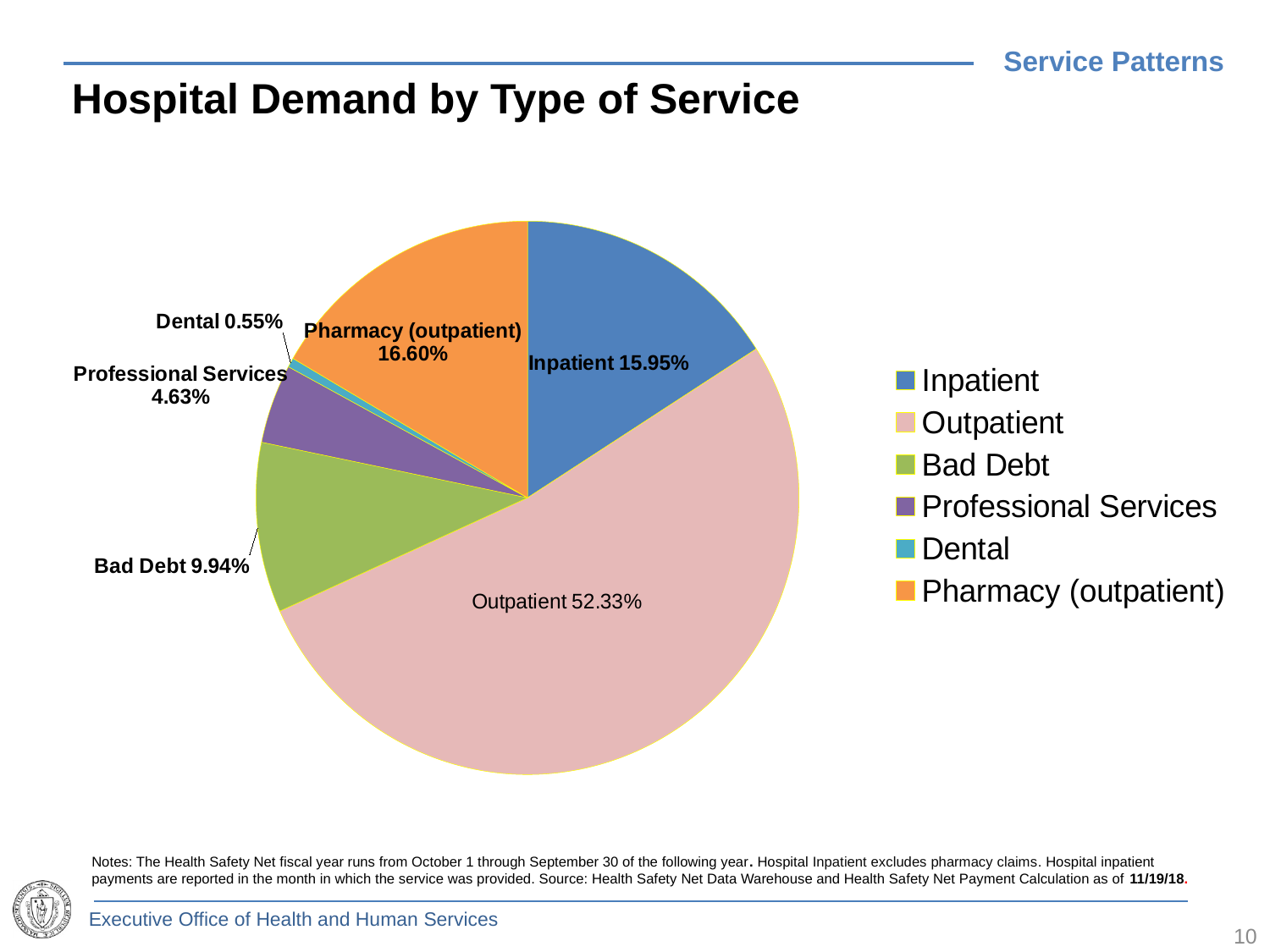
Which has a larger share, Bad Debt or Professional Services? Bad Debt What share of hospital demand is Inpatient? 15.95% What is the difference in percentage points between the Outpatient and Inpatient shares? 36.38 How many types of service are shown in the pie chart? 6 Which type of service has the smallest share of hospital demand? Dental What share of hospital demand is Outpatient? 52.33% Which type of service has the largest share of hospital demand? Outpatient What share of hospital demand is Pharmacy (outpatient)? 16.60% What is the title of the chart? Hospital Demand by Type of Service What share of hospital demand is Bad Debt? 9.94% What kind of chart is shown on the slide? pie chart What share of hospital demand is Dental? 0.55%